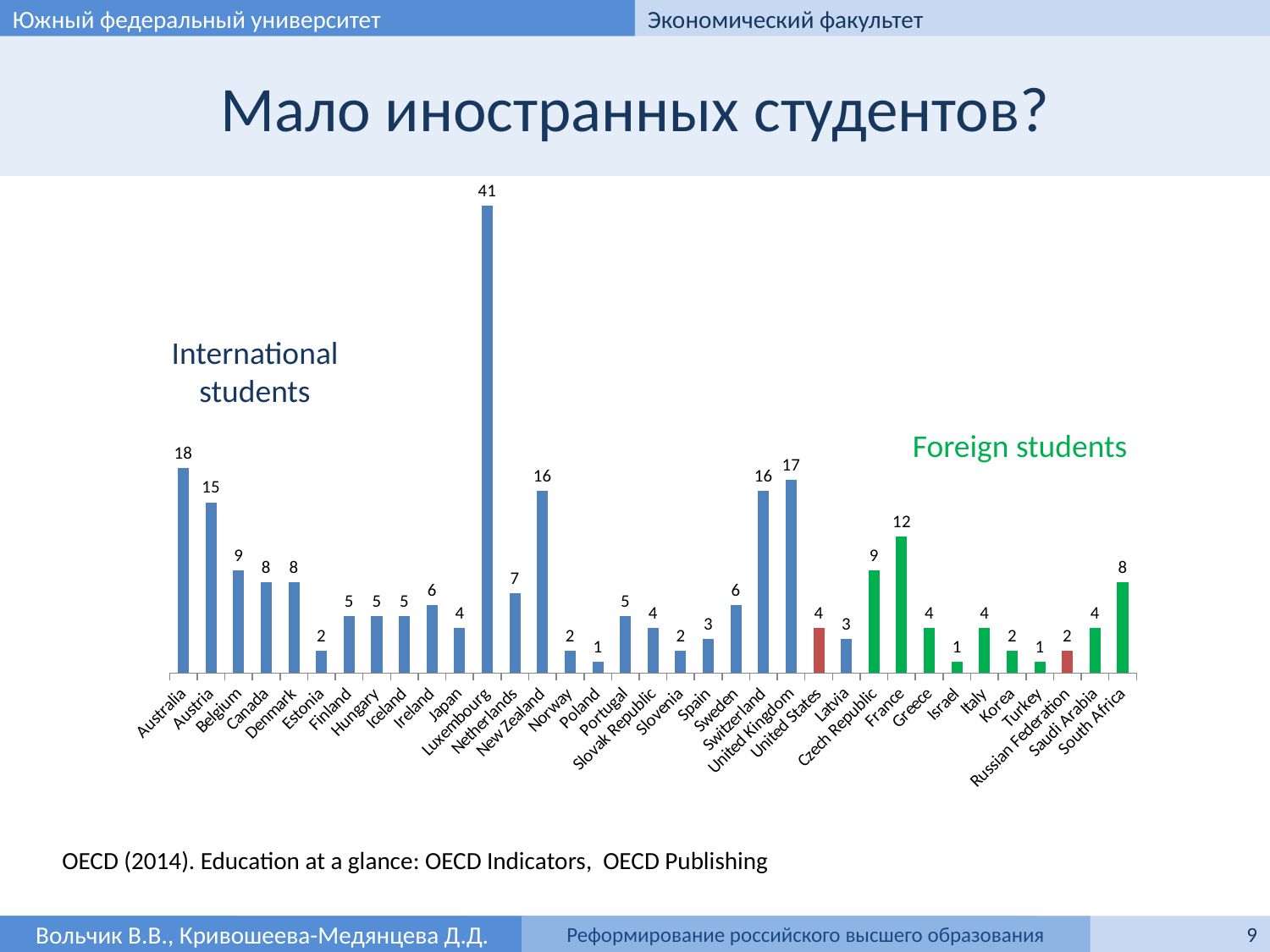
Which has the larger value, New Zealand or Netherlands? New Zealand What kind of chart is shown on the slide? Bar chart Which country has the highest value on the chart? Luxembourg Which has the larger value, Australia or Austria? Australia What is the difference between the values for France and the Czech Republic? 3 What is the difference between the values for Luxembourg and Australia? 23 What is the value for Luxembourg? 41 What is the value for the Russian Federation? 2 What is the value for France? 12 What colour is the bar for the Russian Federation? Red How many countries are shown on the chart? 35 What is the value for the United Kingdom? 17